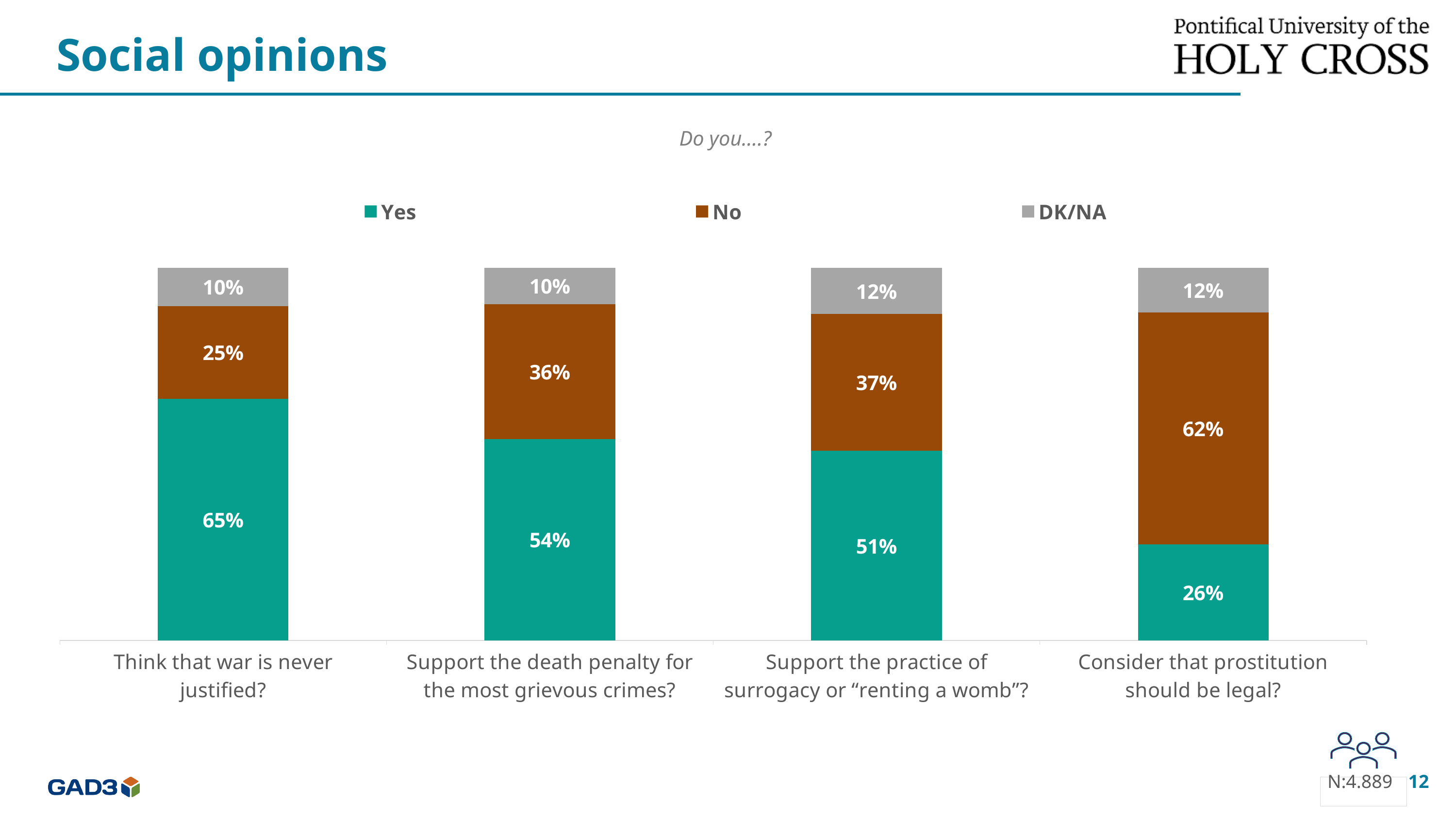
Which question has the lowest Yes percentage? Consider that prostitution should be legal? What percentage answered Yes to "Support the death penalty for the most grievous crimes?" 54% What percentage answered No to "Consider that prostitution should be legal?" 62% What kind of chart is shown on the slide? Stacked bar chart How many questions (categories) are shown on the x axis? 4 What is the total of the stacked bar for "Support the death penalty for the most grievous crimes?" 100% What is the difference between the Yes and No percentages for "Think that war is never justified?" 40% What percentage answered Yes to "Think that war is never justified?" 65% What is the DK/NA percentage for "Support the practice of surrogacy or "renting a womb"?" 12% How many series does the legend list? 3 Is the No percentage higher for the death penalty question or the surrogacy question? Surrogacy question Which question has the highest Yes percentage? Think that war is never justified?